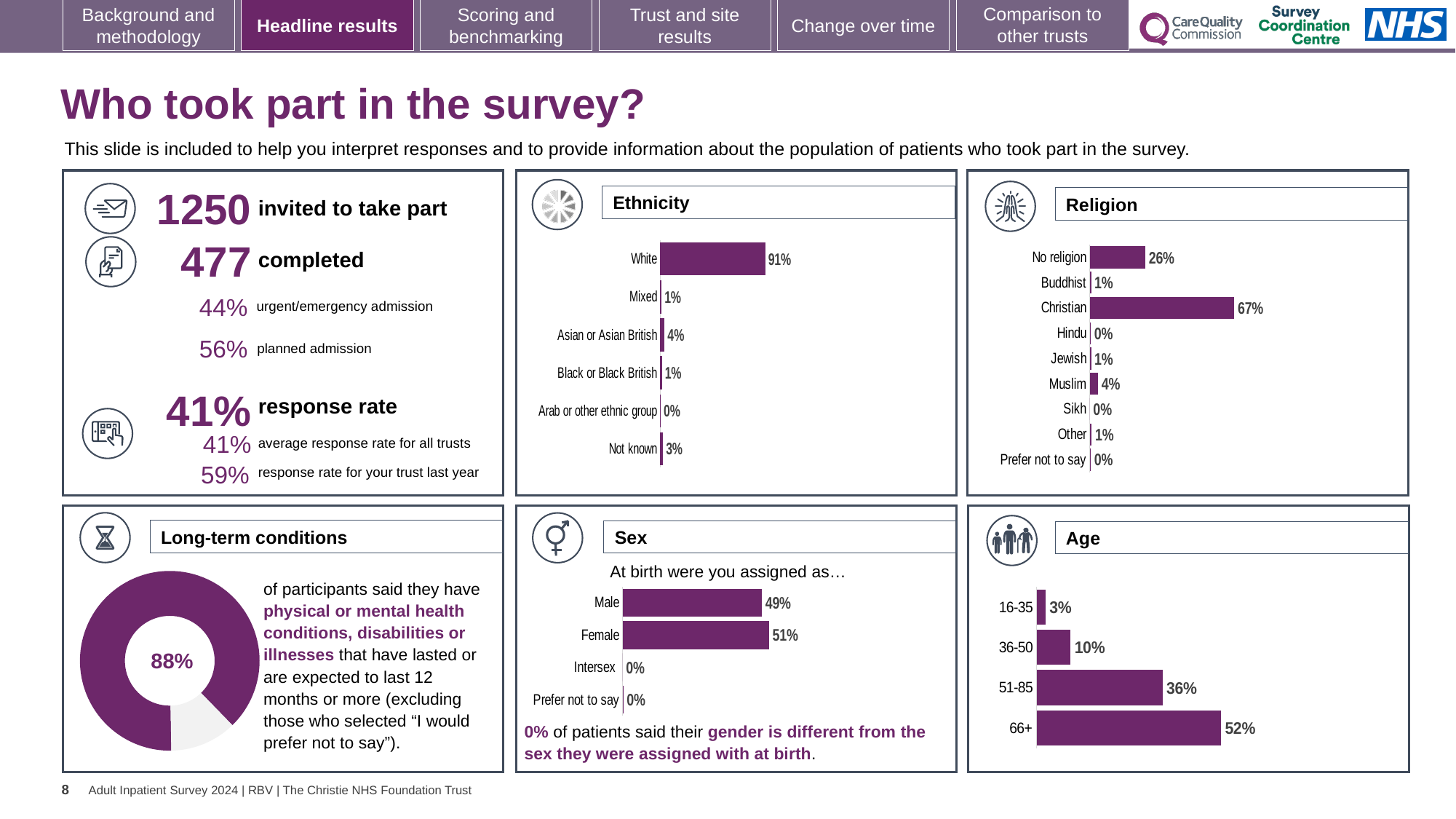
In the Sex chart, which is larger, Male or Female? Female In the Age chart, which age group has the lowest value? 16-35 In the Long-term conditions chart, what share of participants said they have long-term conditions? 88% In the Ethnicity chart, what is the value for Asian or Asian British? 4% In the Religion chart, what is the value for No religion? 26% In the Age chart, what is the difference between the 66+ and 51-85 values? 16% In the Ethnicity chart, what percentage of participants were White? 91% What kind of chart is the Long-term conditions chart? Doughnut chart How many categories does the Ethnicity chart show? 6 In the Religion chart, which category has the highest value? Christian How many categories does the Religion chart show? 9 In the Age chart, do the values rise or fall from 16-35 to 66+? Rise